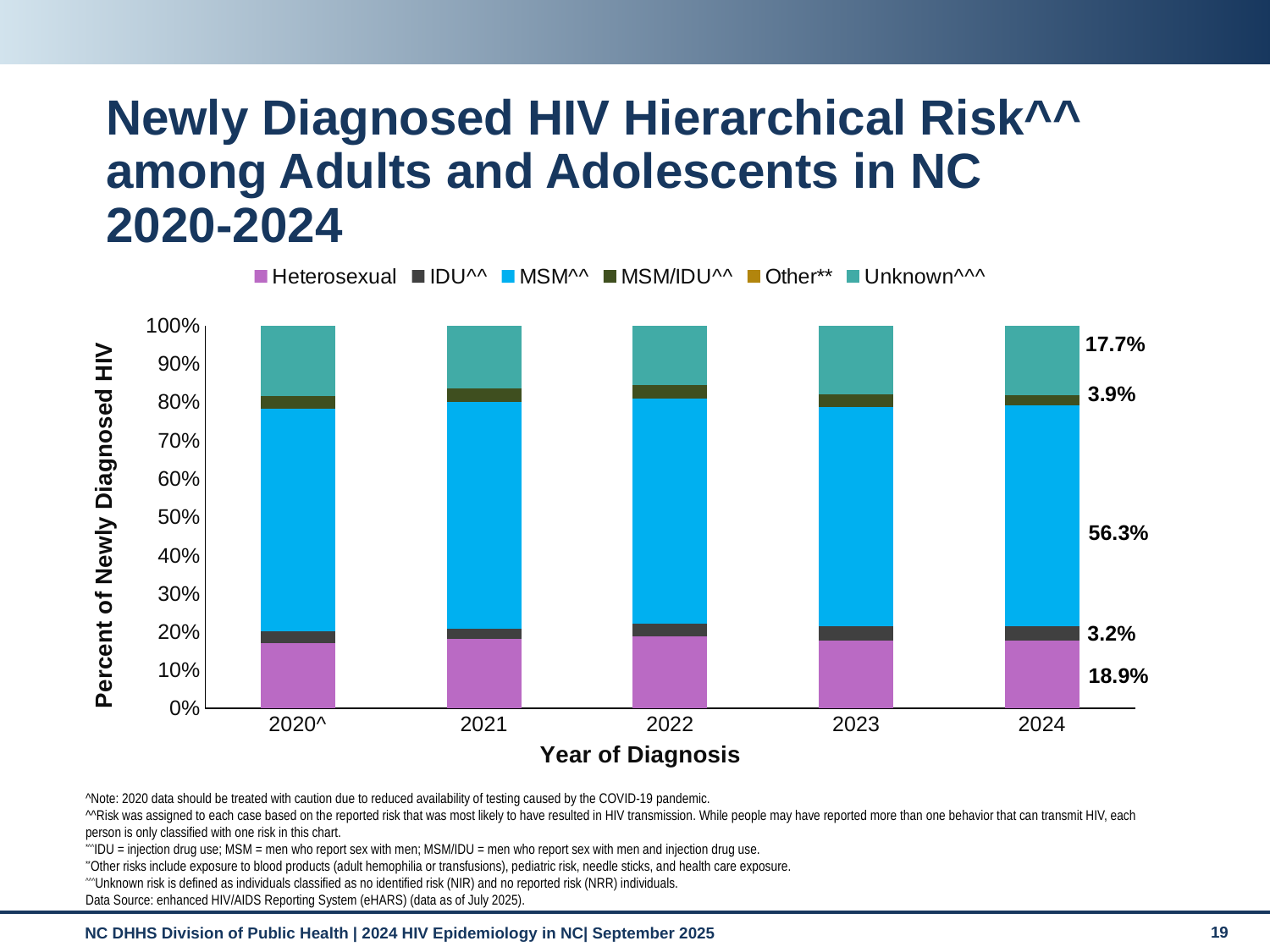
In 2024, which is larger: the Heterosexual share or the Unknown^^^ share? Heterosexual How many years of diagnosis are shown on the x axis? 5 Which risk category accounts for the largest share of newly diagnosed HIV cases in 2024? MSM^^ What percentage of newly diagnosed HIV cases in 2024 were classified as IDU^^? 3.2% How many risk categories does the legend list? 6 What percentage of newly diagnosed HIV cases in 2024 were classified as Heterosexual? 18.9% What kind of chart is shown on the slide? Stacked bar chart Is the MSM^^ share of newly diagnosed HIV cases in 2022 greater or less than 50%? greater In 2024, how much larger is the MSM^^ share than the Heterosexual share? 37.4 percentage points What percentage of newly diagnosed HIV cases in 2024 were classified as MSM^^? 56.3% What percentage of newly diagnosed HIV cases in 2024 were classified as MSM/IDU^^? 3.9% What percentage of newly diagnosed HIV cases in 2024 had Unknown^^^ risk? 17.7%